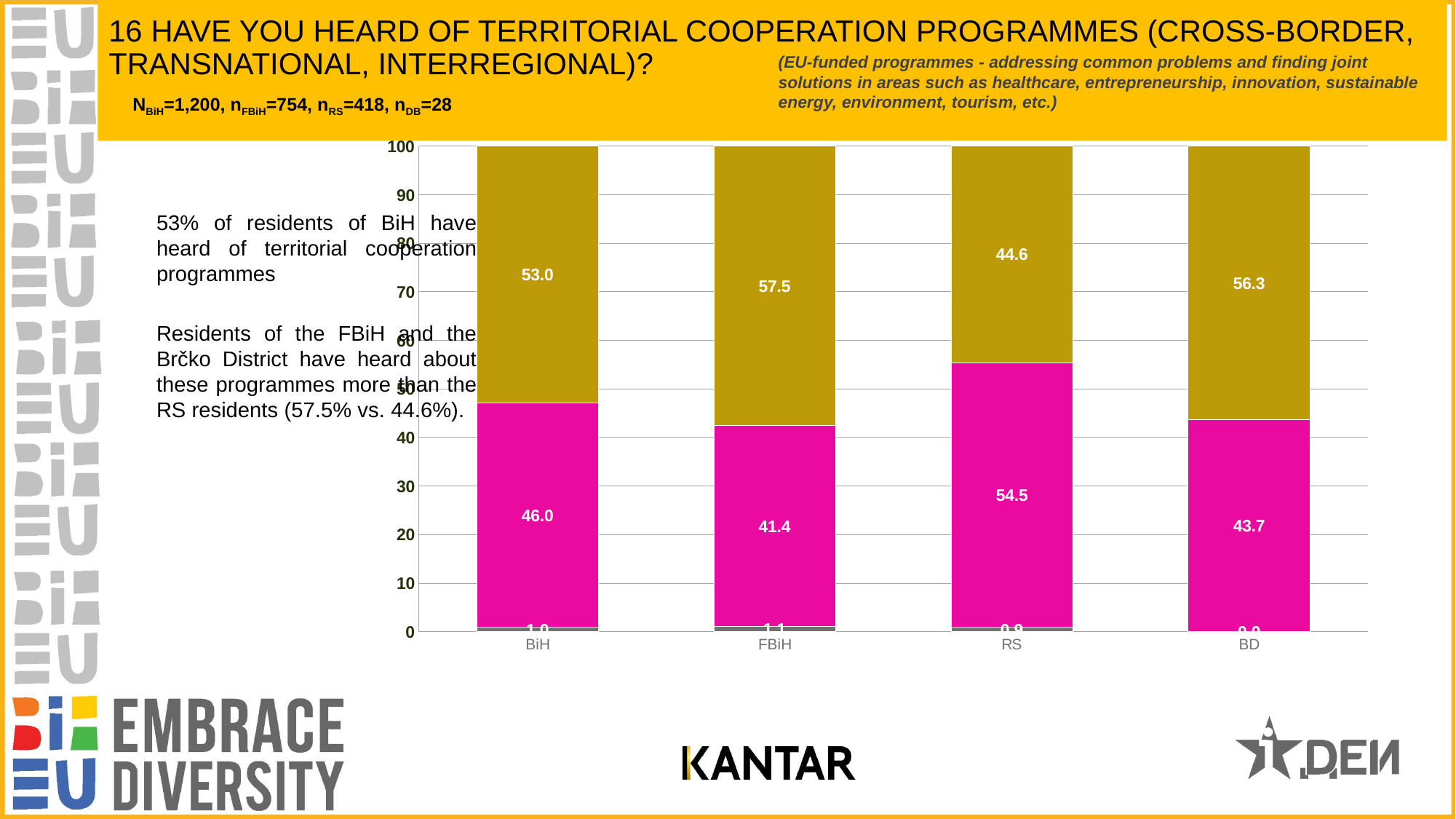
What is the value of the gold (top) segment for BiH? 53.0 Which category has the highest value in the gold (top) segment? FBiH How many categories are shown on the x axis of the chart? 4 What is the value of the gold (top) segment for FBiH? 57.5 Which category has the lowest value in the gold (top) segment? RS Which is larger, the magenta segment for BiH or the magenta segment for FBiH? BiH What is the difference between the gold segment values for FBiH and RS? 12.9 What type of chart is shown on the slide? Stacked bar chart Is the magenta segment value for RS greater or less than 50? greater What is the value of the magenta segment for RS? 54.5 What is the highest value shown on the y axis of the chart? 100 What is the value of the magenta segment for BD? 43.7